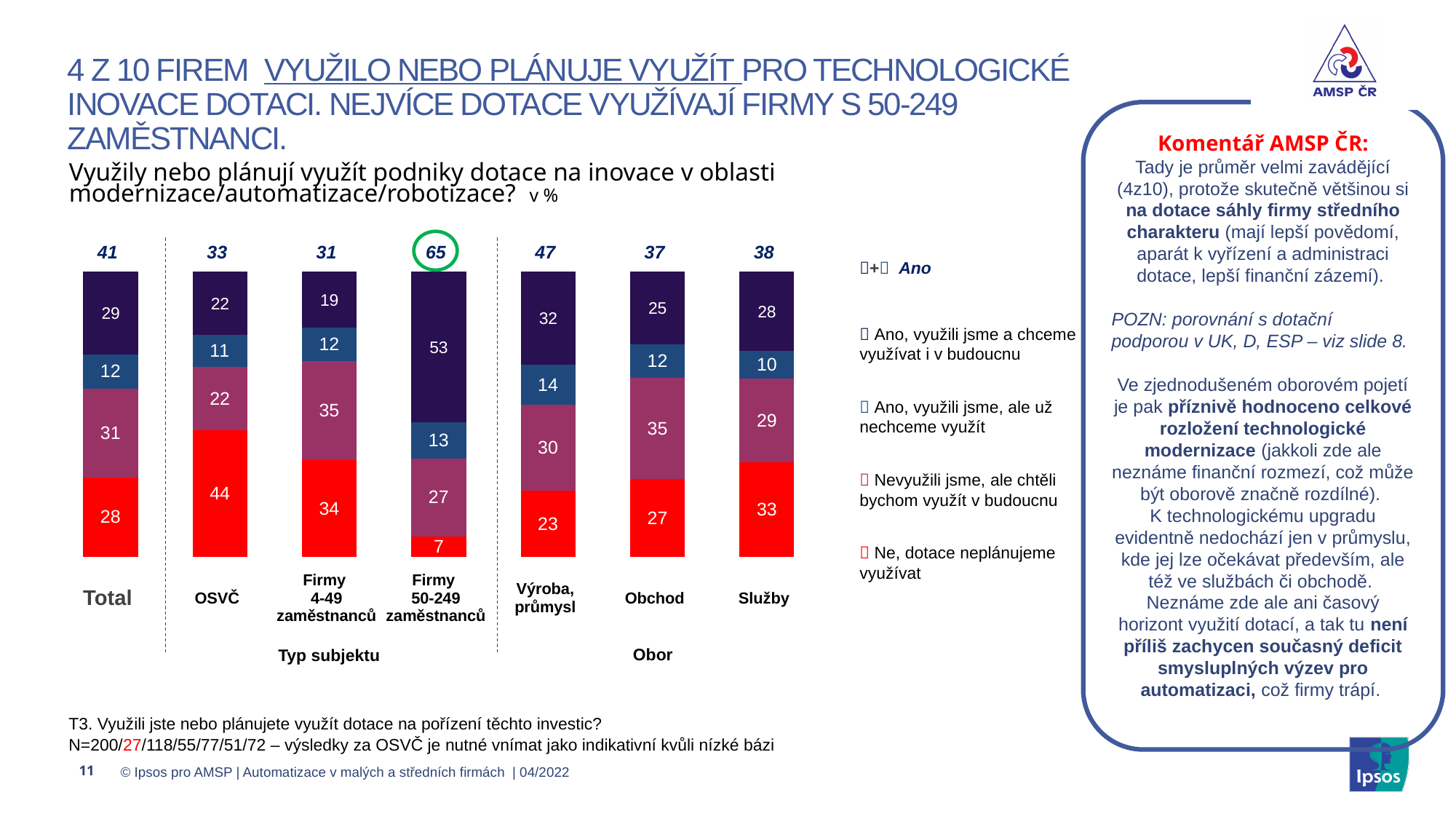
Which category has the lowest combined 'Ano' value shown above the bars? Firmy 4-49 zaměstnanců What is the difference between the 'Ne, dotace neplánujeme využívat' values for OSVČ and Firmy 50-249 zaměstnanců? 37 Which is larger: the 'Nevyužili jsme, ale chtěli bychom využít v budoucnu' value for Obchod or for Služby? Obchod What is the combined 'Ano' value shown above the Výroba, průmysl bar? 47 Which category's combined 'Ano' value is highlighted with a green circle? Firmy 50-249 zaměstnanců How many series does the legend list? 4 What is the value for 'Ne, dotace neplánujeme využívat' in the OSVČ bar? 44 How many categories (bars) are plotted in the chart? 7 Which category has the highest combined 'Ano' value shown above the bars? Firmy 50-249 zaměstnanců What type of chart is shown on the slide? Stacked bar chart What is the value for 'Ano, využili jsme a chceme využívat i v budoucnu' for Firmy 50-249 zaměstnanců? 53 What is the value for 'Ano, využili jsme, ale už nechceme využít' in the Total bar? 12